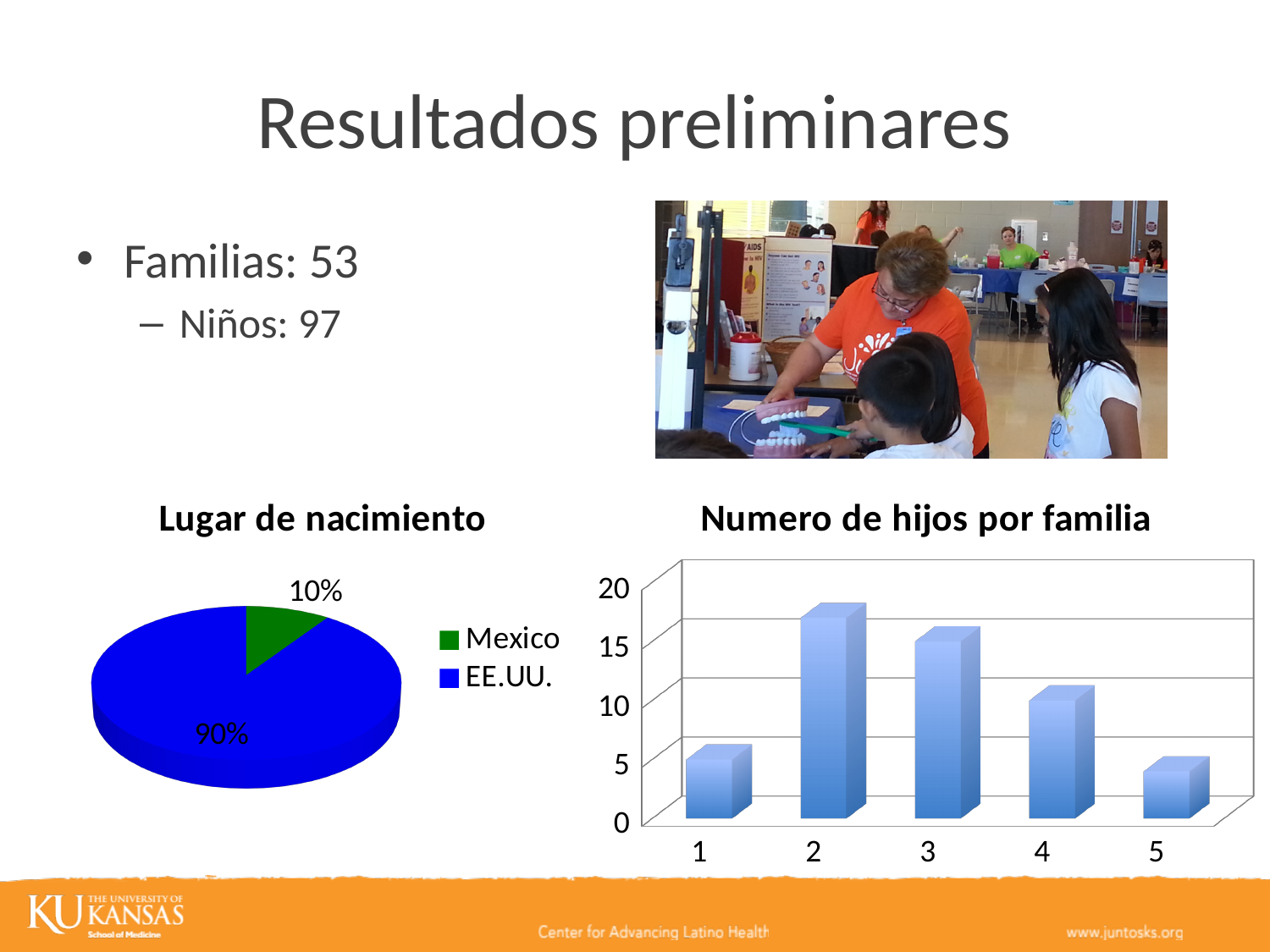
In the 'Lugar de nacimiento' chart, which category has the largest share? EE.UU. What kind of chart is 'Lugar de nacimiento'? Pie chart In the 'Numero de hijos por familia' chart, which is larger, the value for category 3 or the value for category 4? 3 In the 'Lugar de nacimiento' chart, what is the difference in percentage points between EE.UU. and Mexico? 80 In the 'Numero de hijos por familia' chart, which category has the tallest bar? 2 In the 'Lugar de nacimiento' chart, what percentage of the pie is Mexico? 10% How many categories are shown on the x axis of the 'Numero de hijos por familia' chart? 5 In the 'Lugar de nacimiento' chart, what percentage of the pie is EE.UU.? 90% How many entries does the legend of the 'Lugar de nacimiento' chart list? 2 What kind of chart is 'Numero de hijos por familia'? Bar chart In the 'Numero de hijos por familia' chart, is the value for category 2 greater or less than 15? greater In the 'Numero de hijos por familia' chart, is the value for category 4 greater or less than 15? less